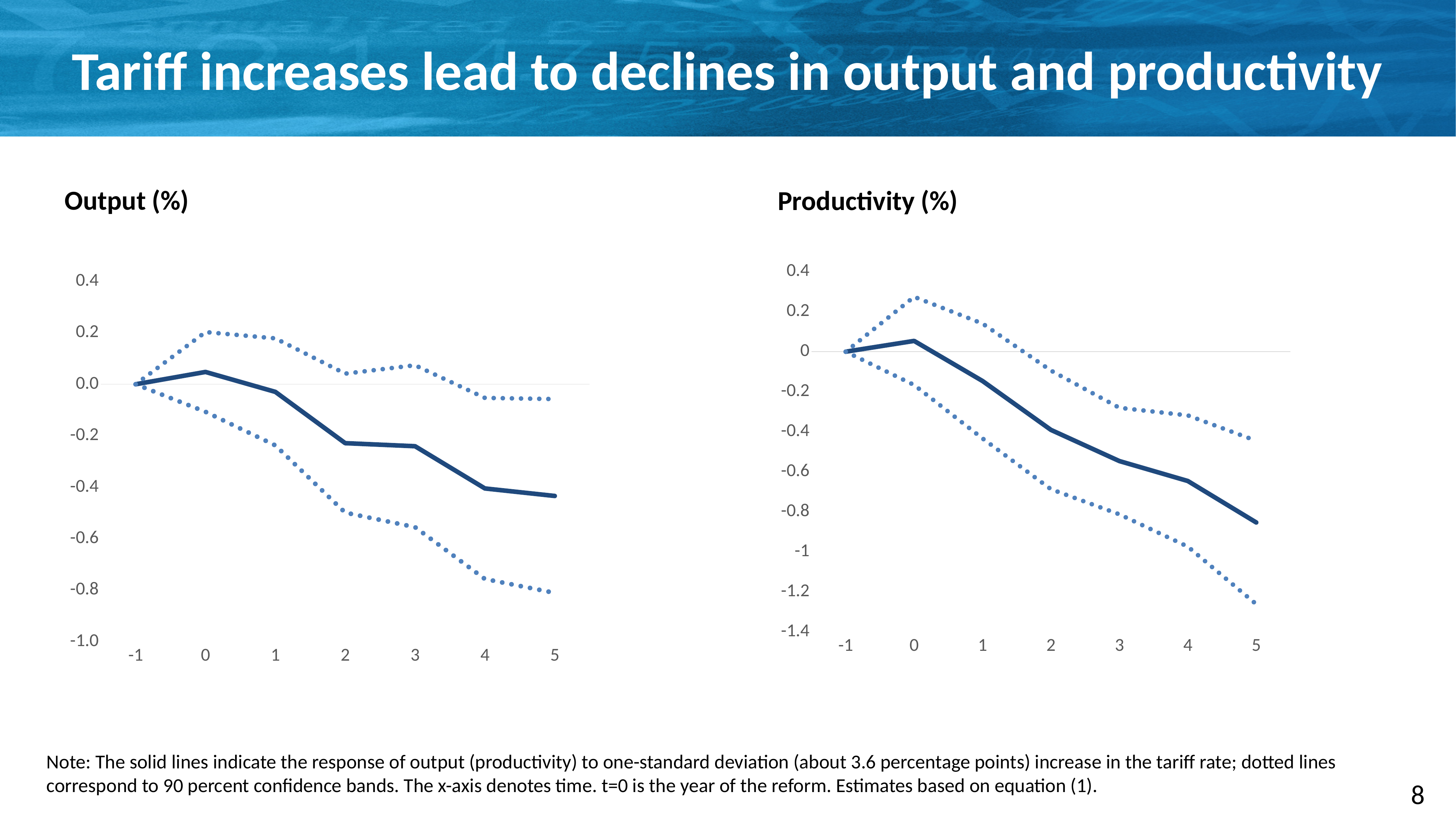
In the Productivity (%) chart, at which time point does the solid line reach its lowest value? 5 What kind of chart is the Output (%) chart? line chart In the Output (%) chart, at which time point does the solid line reach its highest value? 0 In the Productivity (%) chart, is the solid line's value at time 3 greater or less than -0.4? less In the Productivity (%) chart, what is the value of the solid line at time -1? 0 In the Productivity (%) chart, does the solid line generally rise or fall from time 0 to time 5? fall In the Output (%) chart, what is the value of the solid line at time -1? 0.0 In the Output (%) chart, is the solid line's value at time 5 greater or less than -0.4? less How many time points are shown on the x axis of the Productivity (%) chart? 7 In the Output (%) chart, is the solid line's value at time 2 greater or less than -0.2? less At time 5, which solid line has the larger value: the one in the Output (%) chart or the one in the Productivity (%) chart? Output (%)